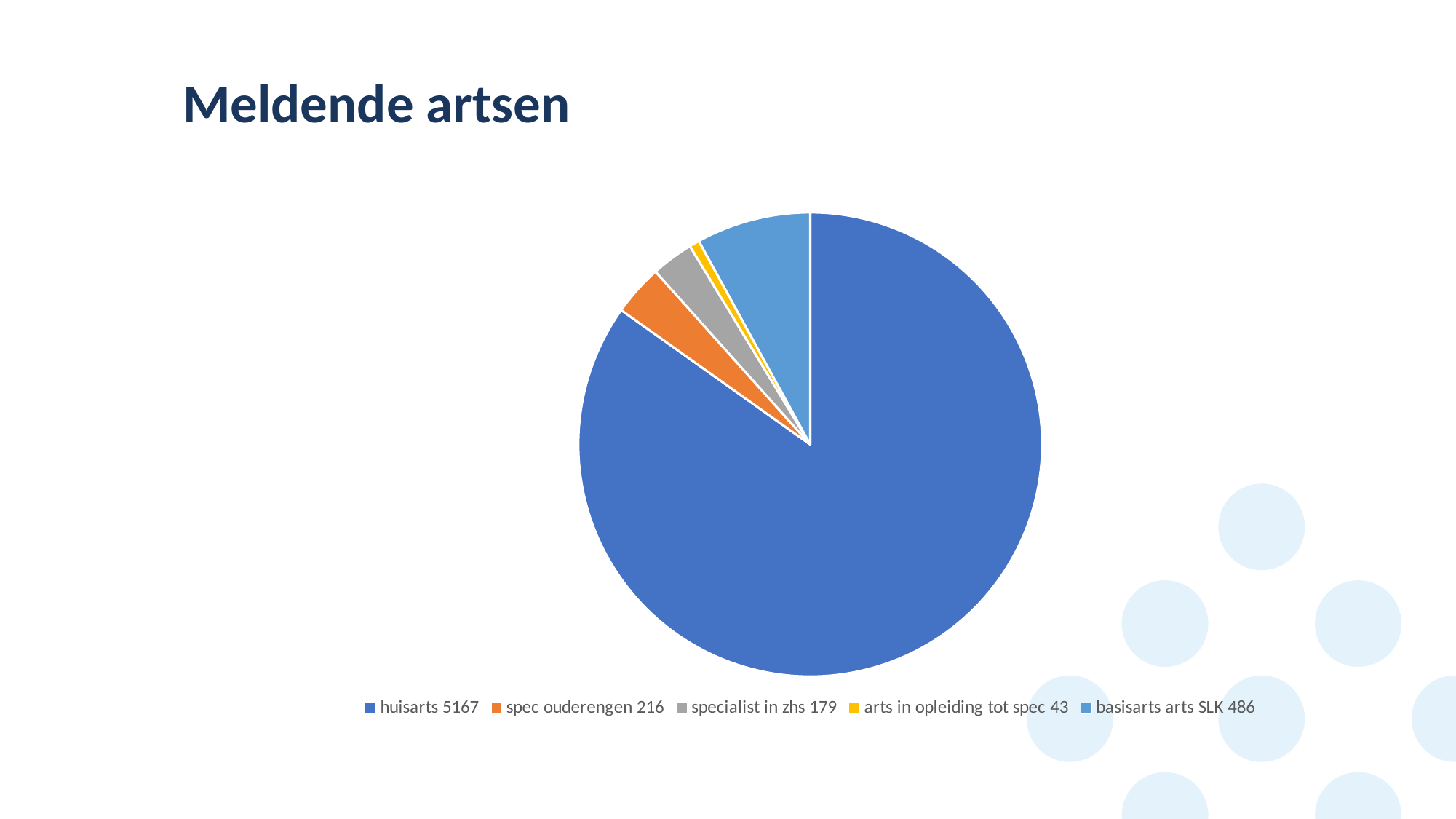
What is the value for huisarts? 5167 What is the value for arts in opleiding tot spec? 43 What is the value for basisarts arts SLK? 486 Which is larger, spec ouderengen or specialist in zhs? spec ouderengen What colour is the slice for spec ouderengen? orange Which category has the smallest slice of the pie? arts in opleiding tot spec What is the title of the slide with the pie chart? Meldende artsen How many categories does the pie chart show? 5 What is the difference between the values for huisarts and basisarts arts SLK? 4681 What is the difference between the values for spec ouderengen and specialist in zhs? 37 What kind of chart is shown on the slide? pie chart Which category has the largest slice of the pie? huisarts